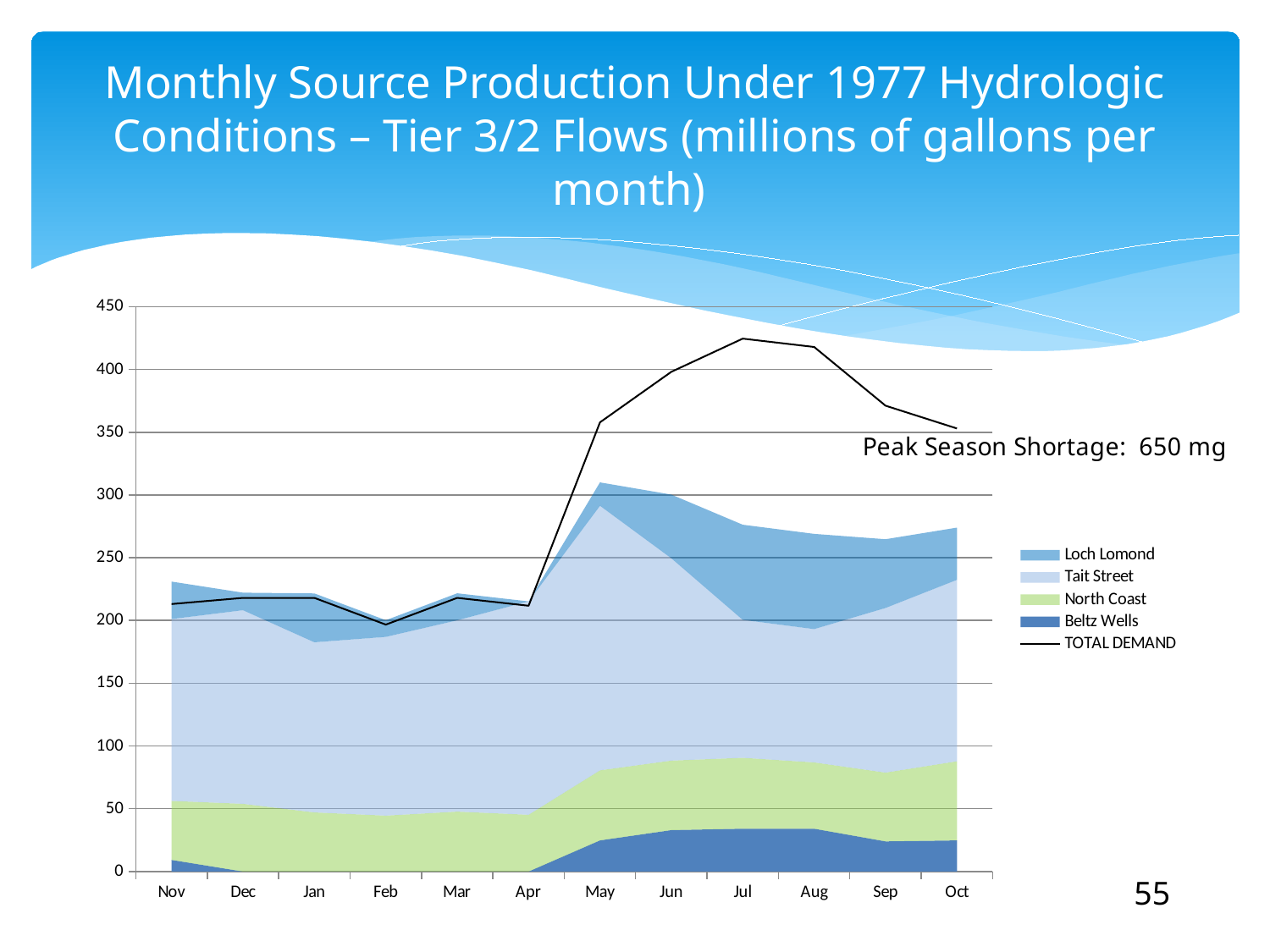
In which month is TOTAL DEMAND highest? Jul Is the TOTAL DEMAND value for Sep greater or less than 350? greater Does TOTAL DEMAND rise or fall from Apr to Jul? rise Is the TOTAL DEMAND value for Jul greater or less than 400? greater How many months are shown along the x axis? 12 How many series does the legend list? 5 Is the TOTAL DEMAND value for Nov greater or less than 250? less What peak season shortage is stated on the slide? 650 mg In which month is TOTAL DEMAND lowest? Feb Which month has the larger TOTAL DEMAND, Aug or Sep? Aug What kind of chart is shown on the slide? Stacked area chart with a line Which series is shown in green in the legend? North Coast